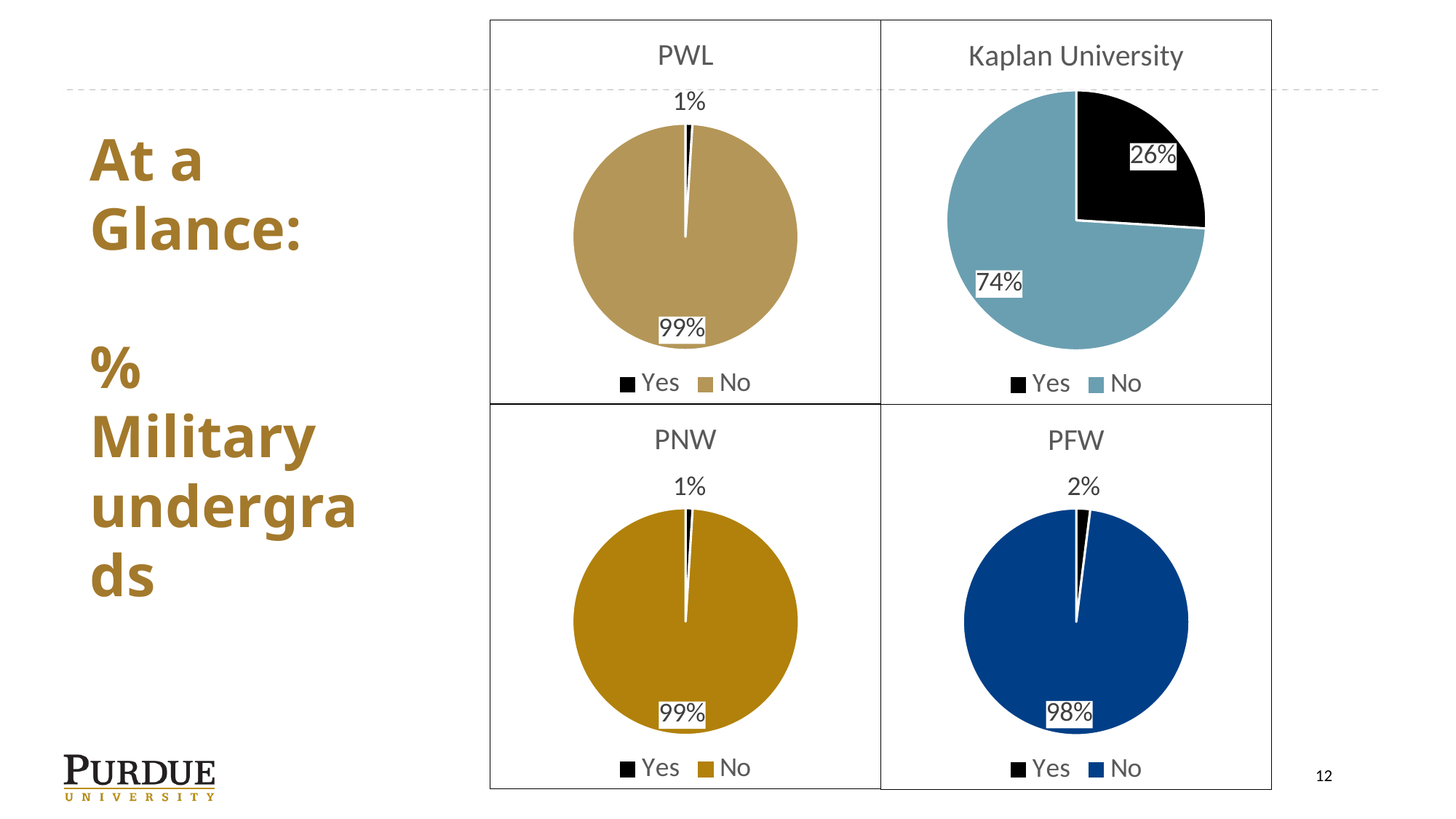
In the Kaplan University chart, what percentage is shown for the Yes slice? 26% In the PNW chart, what percentage is shown for the Yes slice? 1% In the PFW chart, what is the difference between the No and Yes percentages? 96% In the Kaplan University chart, which slice is larger, Yes or No? No What kind of chart is the PNW chart? Pie chart In the Kaplan University chart, what percentage is shown for the No slice? 74% In the PWL chart, what percentage is shown for the Yes slice? 1% In the Kaplan University chart, what colour is the Yes slice? Black How many entries does the legend of the PWL chart list? 2 In the Kaplan University chart, what is the difference between the No and Yes percentages? 48% In the PFW chart, what percentage is shown for the No slice? 98% How many slices does the PFW chart have? 2